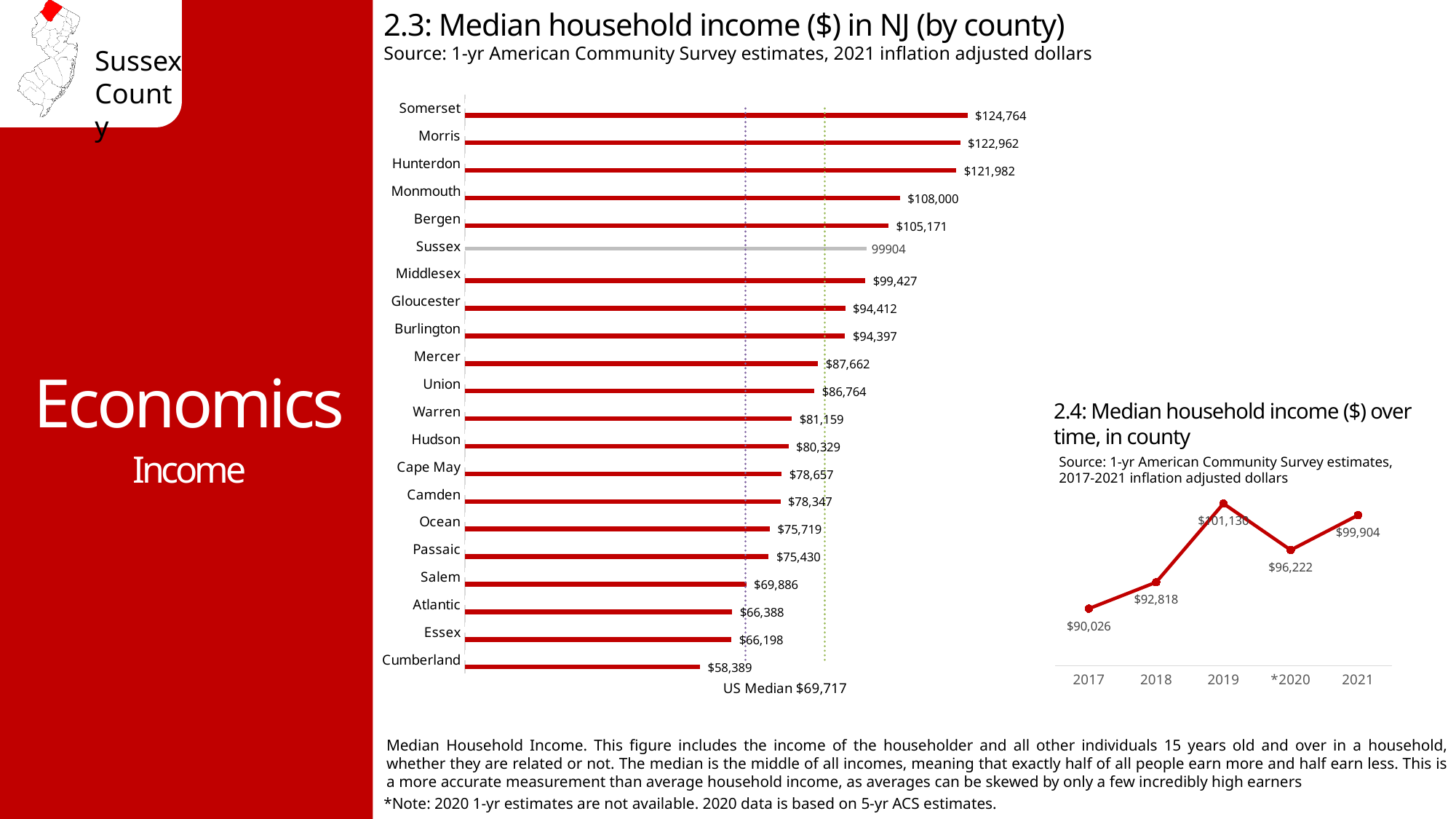
In chart 2.3, what is the median household income for Sussex? 99904 In chart 2.3, which county has the highest median household income? Somerset In chart 2.3, how many counties are shown? 21 In chart 2.3 (Median household income in NJ by county), what is the median household income for Somerset? $124,764 In chart 2.4 (Median household income over time, in county), what is the median household income for 2021? $99,904 In chart 2.3, what US median value is noted below the chart? $69,717 In chart 2.3, what is the difference between the median household income of Morris and Hunterdon? $980 In chart 2.3, which county has the lowest median household income? Cumberland In chart 2.4, what is the difference between the 2018 and 2017 values? $2,792 In chart 2.3, which county has a higher median household income, Bergen or Monmouth? Monmouth In chart 2.4, how many years are plotted? 5 What kind of chart is chart 2.3? Bar chart